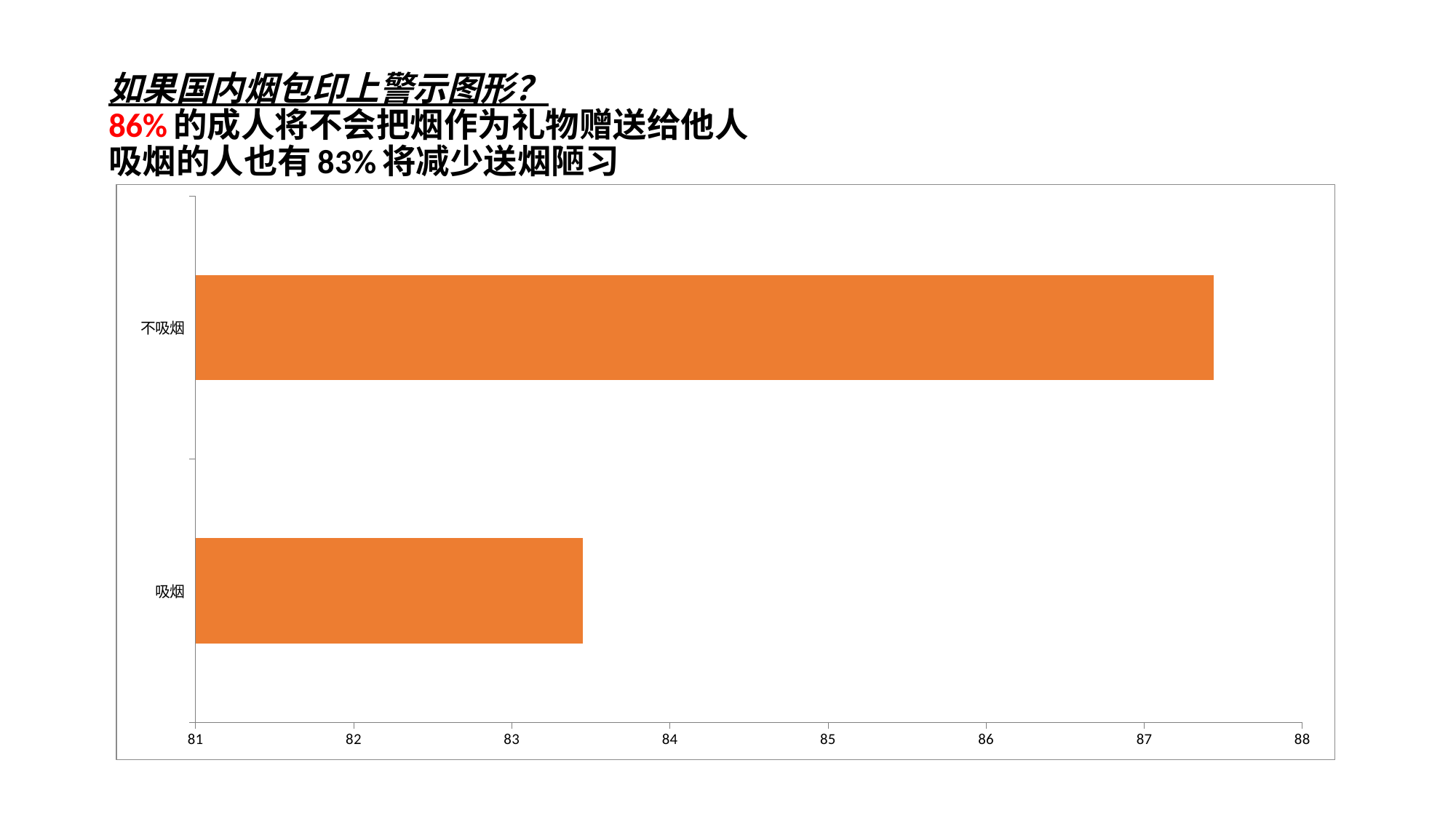
Is the value for 不吸烟 greater or less than 87? greater Which category has the lowest value in the chart? 吸烟 What kind of chart is shown on the slide? bar chart Which category has the highest value in the chart? 不吸烟 Which is larger, the value for 不吸烟 or the value for 吸烟? 不吸烟 What is the lowest value shown on the horizontal axis of the chart? 81 What colour are the bars in the chart? orange Is the value for 不吸烟 greater or less than 88? less Is the value for 吸烟 greater or less than 84? less How many categories are plotted in the chart? 2